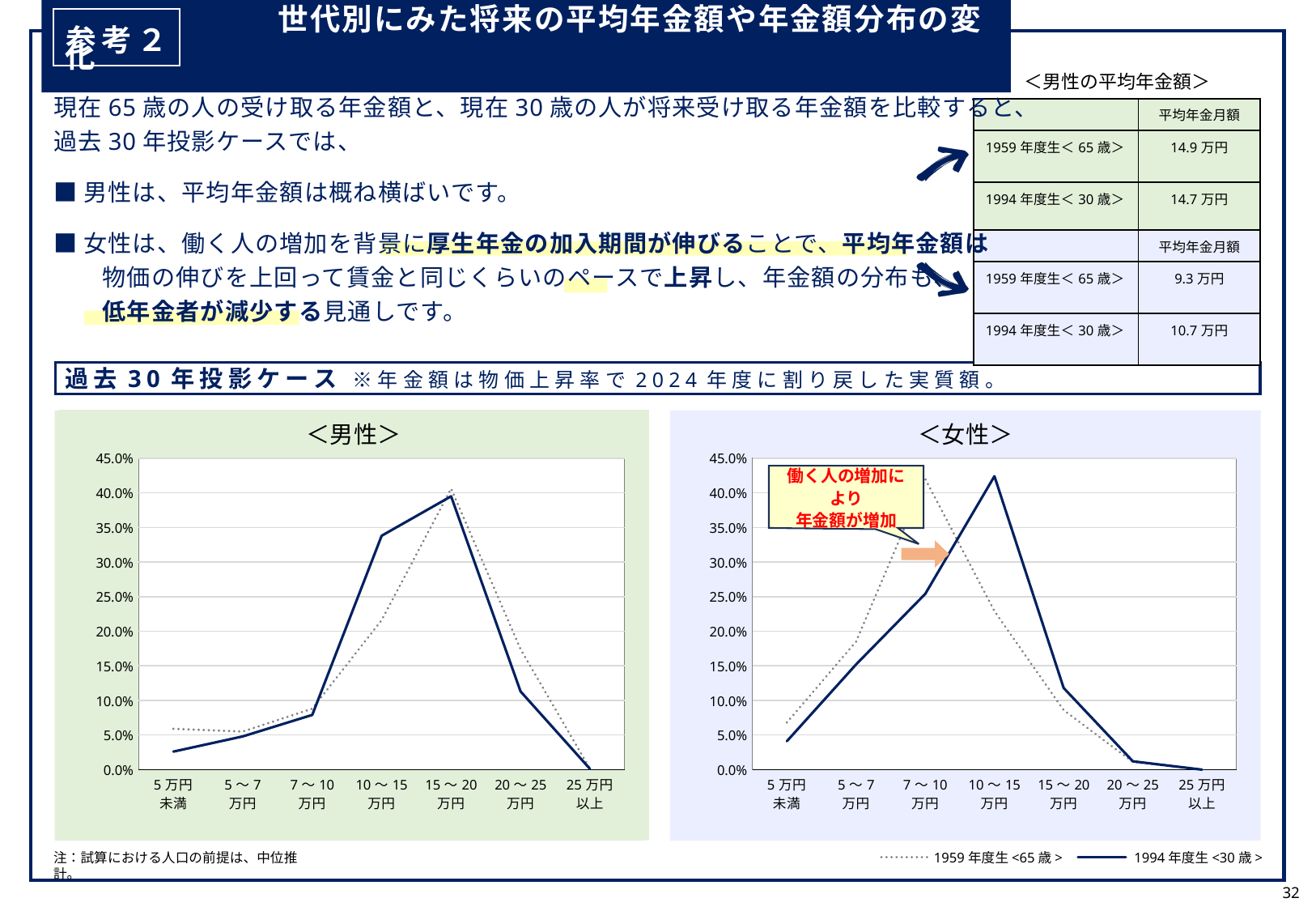
In the <男性> chart, is the value for 10～15万円 in the 1994年度生<30歳> series greater or less than 30.0%? greater In the <女性> chart, which category has the highest value for the 1959年度生<65歳> series? 7～10万円 How many series does the legend list for the charts? 2 In the <女性> chart, is the value for 7～10万円 in the 1994年度生<30歳> series greater or less than 30.0%? less How many categories are on the x axis of the <女性> chart? 7 In the <男性> chart, which series has the larger value at 10～15万円, 1959年度生<65歳> or 1994年度生<30歳>? 1994年度生<30歳> In the <男性> chart, which category has the highest value for the 1994年度生<30歳> series? 15～20万円 What kind of chart is the <男性> chart? line chart In the <女性> chart, which series has the larger value at 7～10万円, 1959年度生<65歳> or 1994年度生<30歳>? 1959年度生<65歳> In the <女性> chart, is the value for 10～15万円 in the 1994年度生<30歳> series greater or less than 40.0%? greater In the <男性> chart, does the 1994年度生<30歳> series rise or fall from 15～20万円 to 25万円以上? fall In the <女性> chart, which category has the highest value for the 1994年度生<30歳> series? 10～15万円